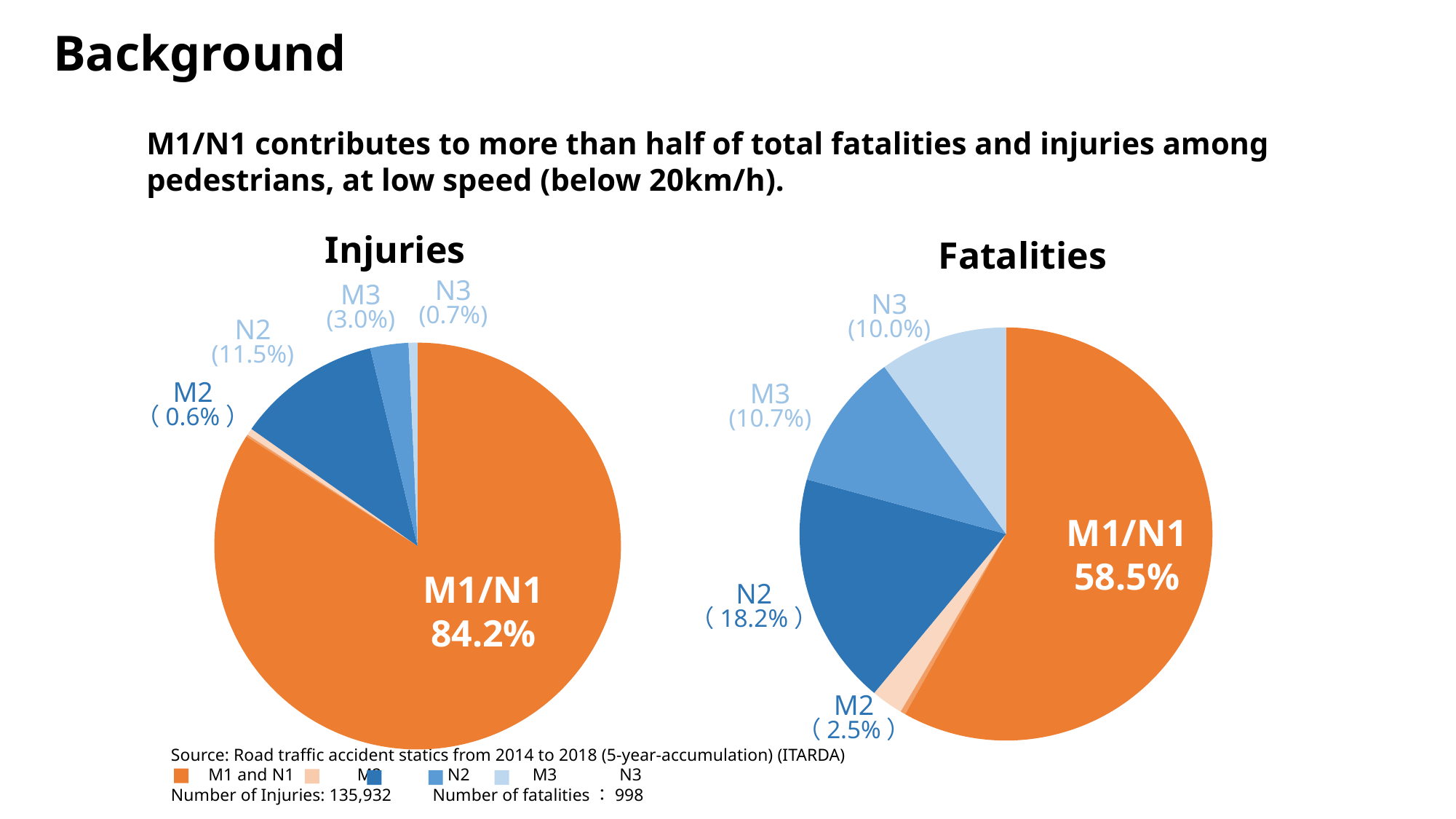
In the Injuries pie chart, what share does M1/N1 account for? 84.2% In the Injuries pie chart, what is the value for N2? 11.5% In the Fatalities pie chart, which category has the largest share? M1/N1 How many slices does the Injuries pie chart have? 5 In the Fatalities pie chart, what is the value for M3? 10.7% In the Injuries pie chart, which category has the smallest share? M2 What is the title of the chart on the left? Injuries In the Fatalities pie chart, what share does N2 account for? 18.2% In the Fatalities pie chart, what is the difference between the N2 share and the M2 share? 15.7% What is the difference between the M1/N1 share in the Injuries chart and the M1/N1 share in the Fatalities chart? 25.7% In the Fatalities pie chart, which is larger, the share for M3 or the share for N3? M3 What type of chart is used for Fatalities? Pie chart